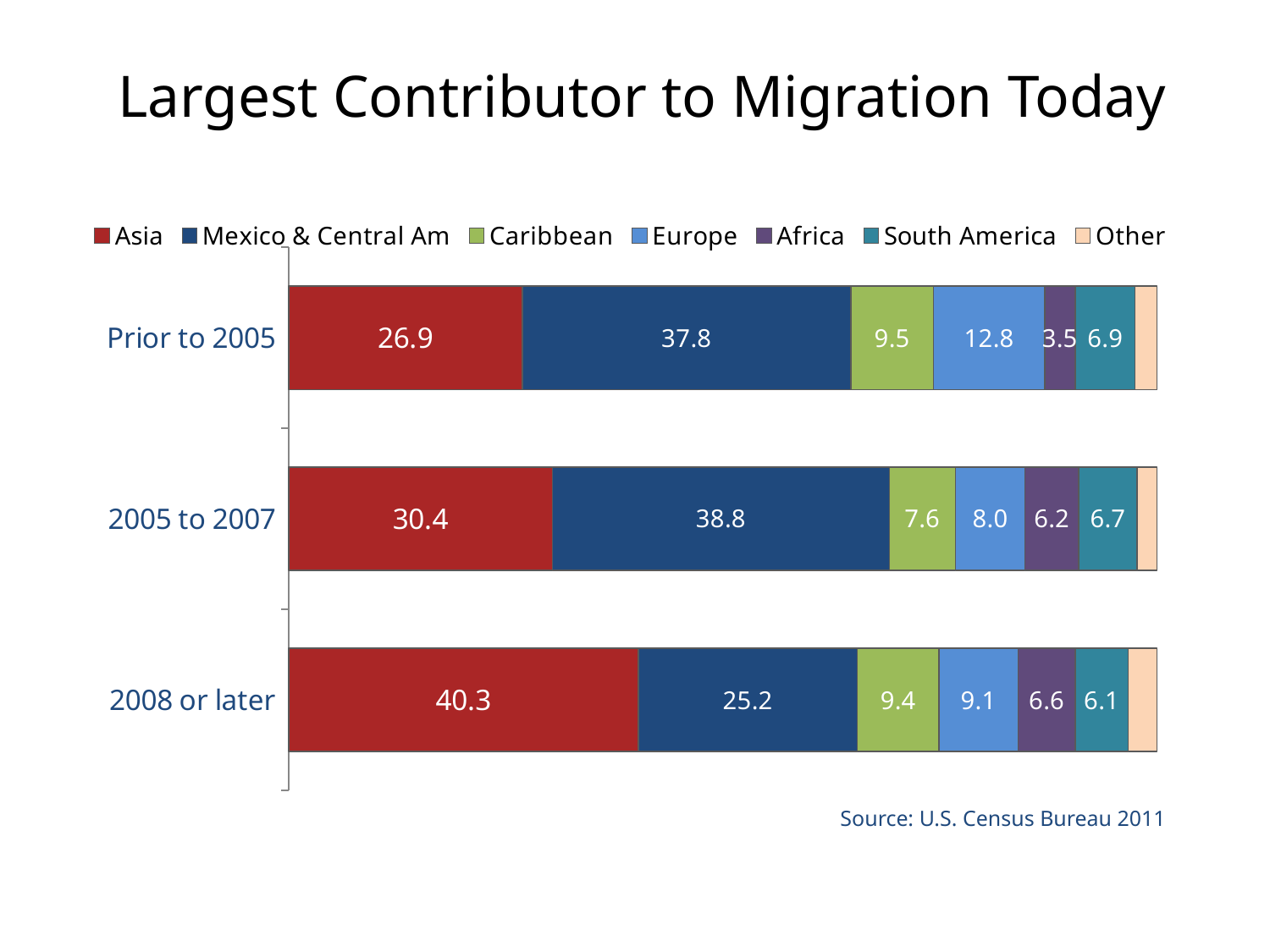
Which period has the highest value for Asia? 2008 or later Which is larger in the 2005 to 2007 bar: Caribbean or Europe? Europe What is the difference between the Asia values for 2008 or later and Prior to 2005? 13.4 What is the value for Europe in the 2005 to 2007 bar? 8.0 How many periods (bars) are shown in the chart? 3 What kind of chart is shown on the slide? Stacked bar chart Which period has the lowest value for Mexico & Central Am? 2008 or later What is the value for Mexico & Central Am in the Prior to 2005 bar? 37.8 What is the value for Asia in the 2008 or later bar? 40.3 What is the title of the chart? Largest Contributor to Migration Today What is the value for Africa in the Prior to 2005 bar? 3.5 How many series does the legend list? 7